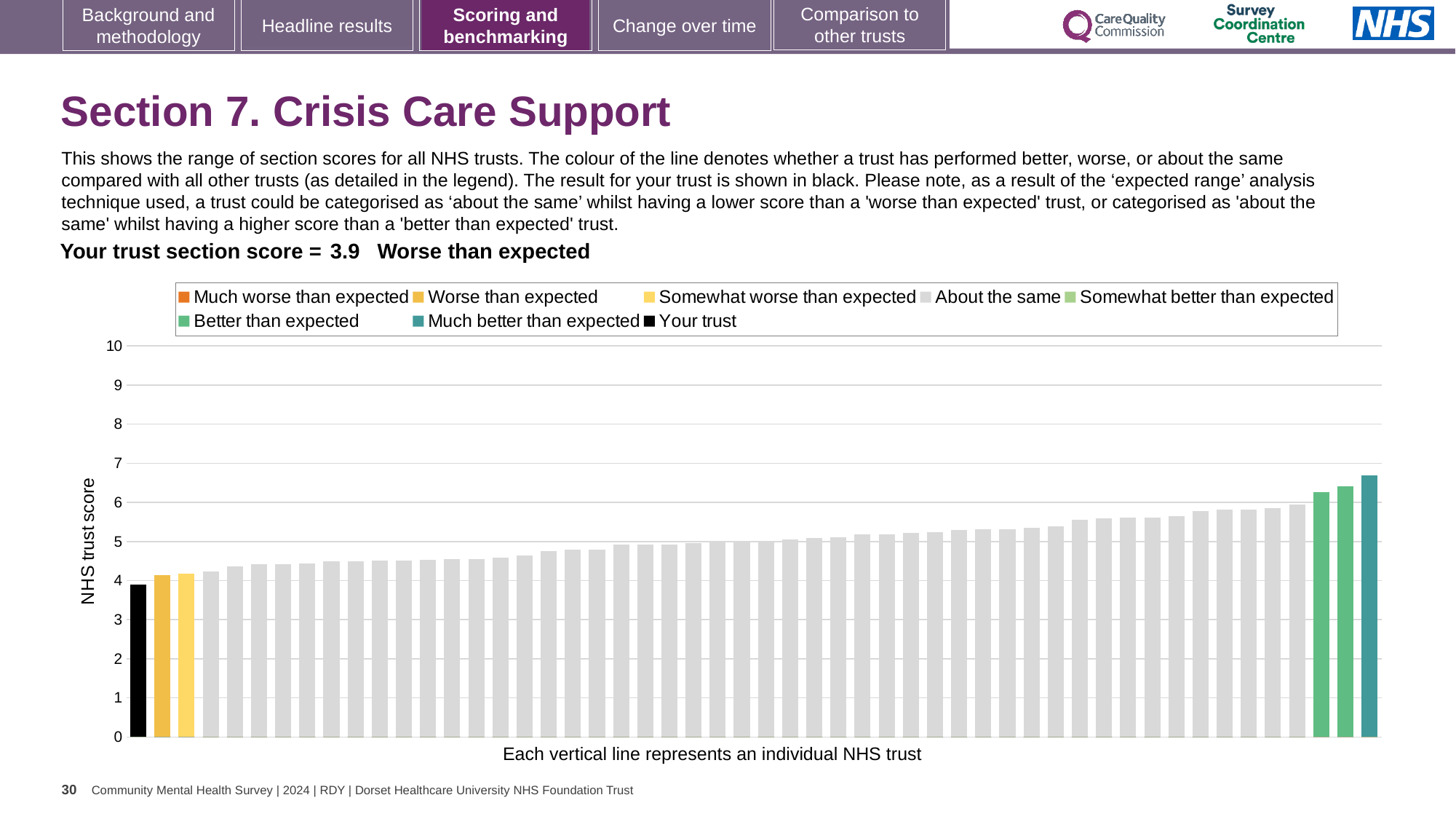
How many entries does the chart legend list? 8 Is the value of the highest bar greater or less than 6? greater Do the bar values rise or fall from left to right along the x axis? Rise How many bars are coloured as 'Better than expected' (green)? 2 How many bars are coloured as 'Worse than expected' (yellow)? 1 What is the section score for your trust shown on the slide? 3.9 Which bar is the lowest in the chart? Your trust (the black bar) What kind of chart is shown on the slide? Bar chart Which legend category does the highest bar in the chart belong to? Much better than expected Is the value of the highest bar greater or less than 7? less What is the label on the vertical axis of the chart? NHS trust score Which performance category is your trust placed in for this section? Worse than expected